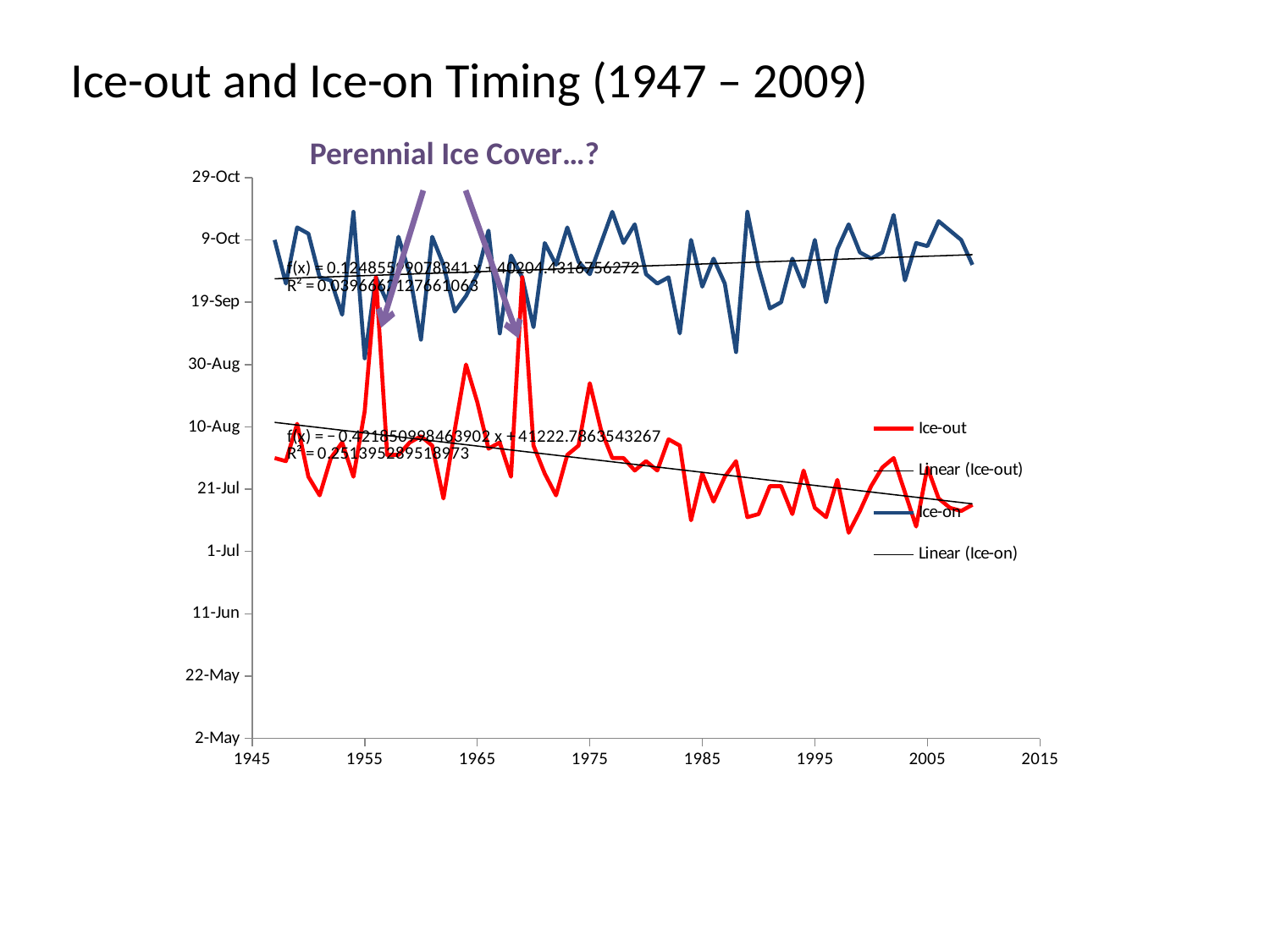
How many entries does the chart legend list? 4 What kind of chart is shown on the slide? Line chart Is the Ice-on value around 1988 earlier or later than 19-Sep? Earlier What colour is the Ice-out series drawn in? Red What is the range of years shown on the x axis? 1945 to 2015 Does the Ice-out series generally rise or fall from 1947 to 2009? Fall What is the earliest date label shown on the y axis? 2-May Is the Ice-out value around 1998 earlier or later than 21-Jul? Earlier Which series has the later dates throughout the chart, Ice-out or Ice-on? Ice-on Is the Ice-out value around 1956 later or earlier than 30-Aug? Later Does the Linear (Ice-on) trendline rise or fall across the x axis? Rise